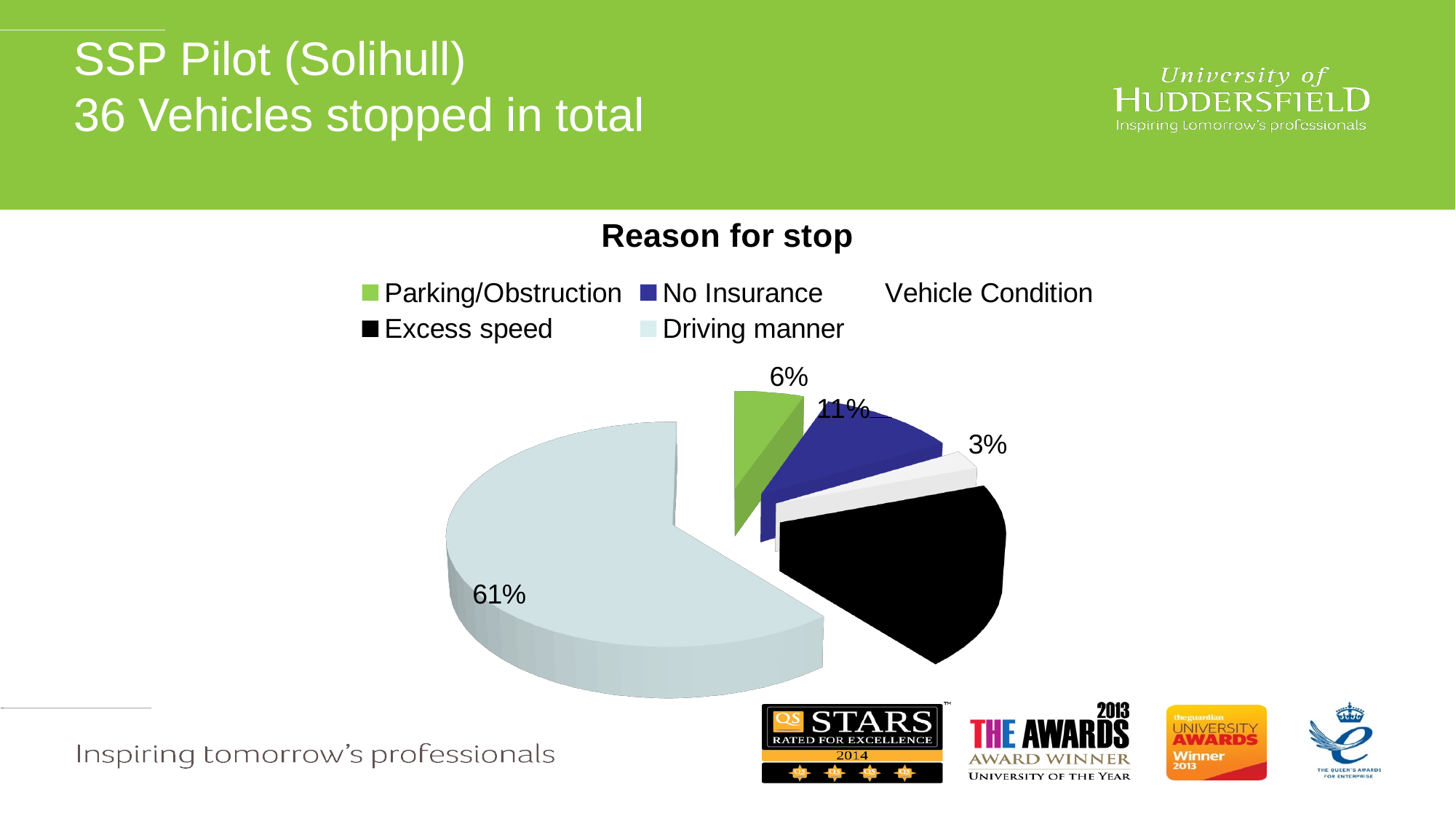
What colour is the Excess speed slice? black What is the title of the chart? Reason for stop How many percentage points larger is the No Insurance share than the Parking/Obstruction share? 5 percentage points What percentage of stops were for Driving manner? 61% What kind of chart is shown on the slide? pie chart What percentage of stops were for Parking/Obstruction? 6% How many reasons for stop does the legend list? 5 Which reason for stop accounts for the largest share of the pie? Driving manner What percentage of stops were for No Insurance? 11% Which reason for stop accounts for the smallest share of the pie? Vehicle Condition Which is larger: the share for Excess speed or the share for Driving manner? Driving manner What percentage of stops were for Vehicle Condition? 3%